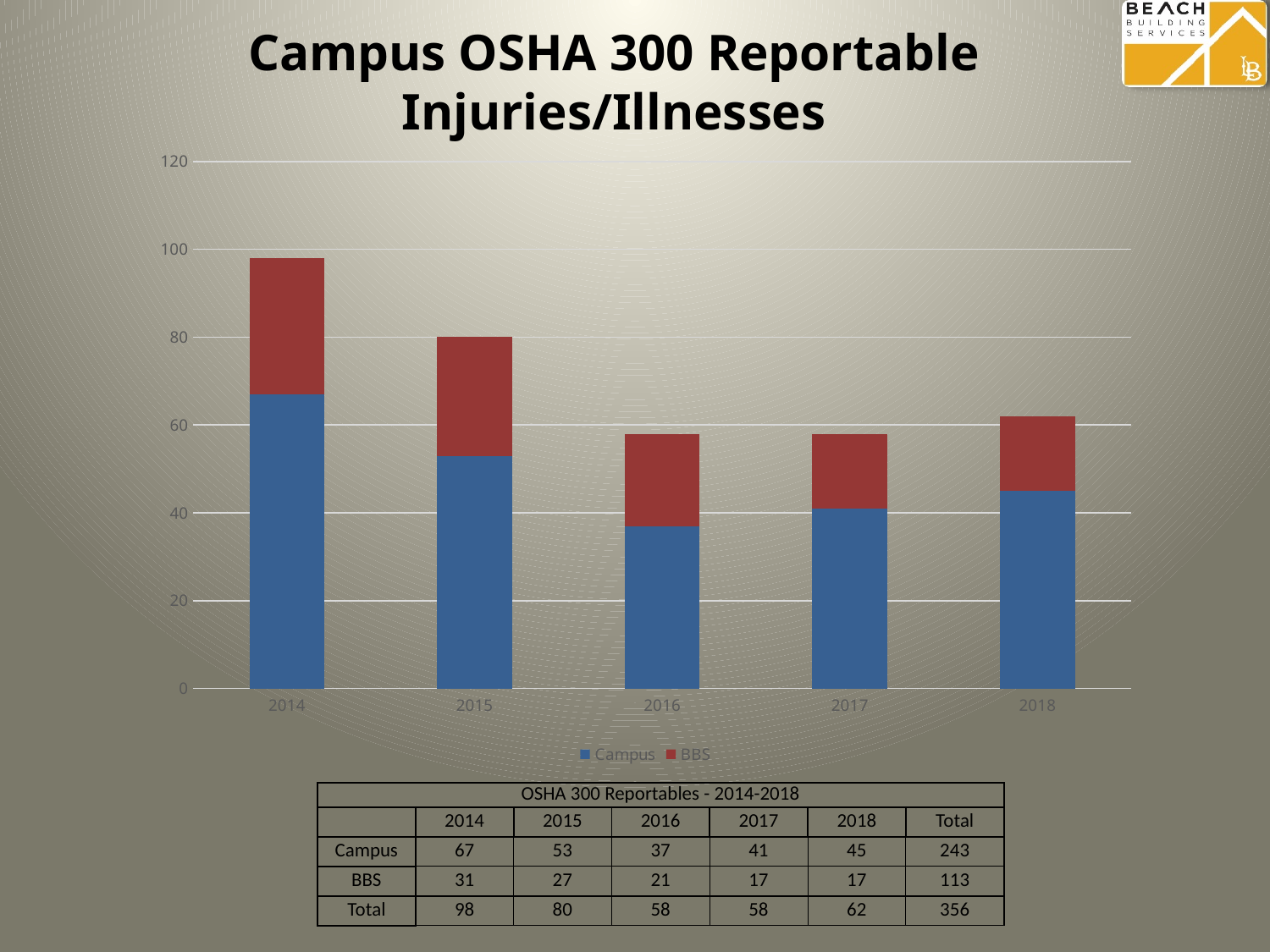
Which is larger, the BBS value for 2015 or the BBS value for 2017? 2015 What kind of chart is shown on the slide? Stacked bar chart What is the Campus value for 2014? 67 Which series is shown in blue in the legend? Campus How many series does the legend list? 2 What is the BBS value for 2016? 21 What is the total of the stacked bar for 2015? 80 Which year has the lowest Campus value? 2016 Which year has the highest total of reportable injuries/illnesses? 2014 What is the difference between the Campus values for 2014 and 2018? 22 Is the total for 2018 greater or less than 80? less How many years are plotted along the x axis? 5